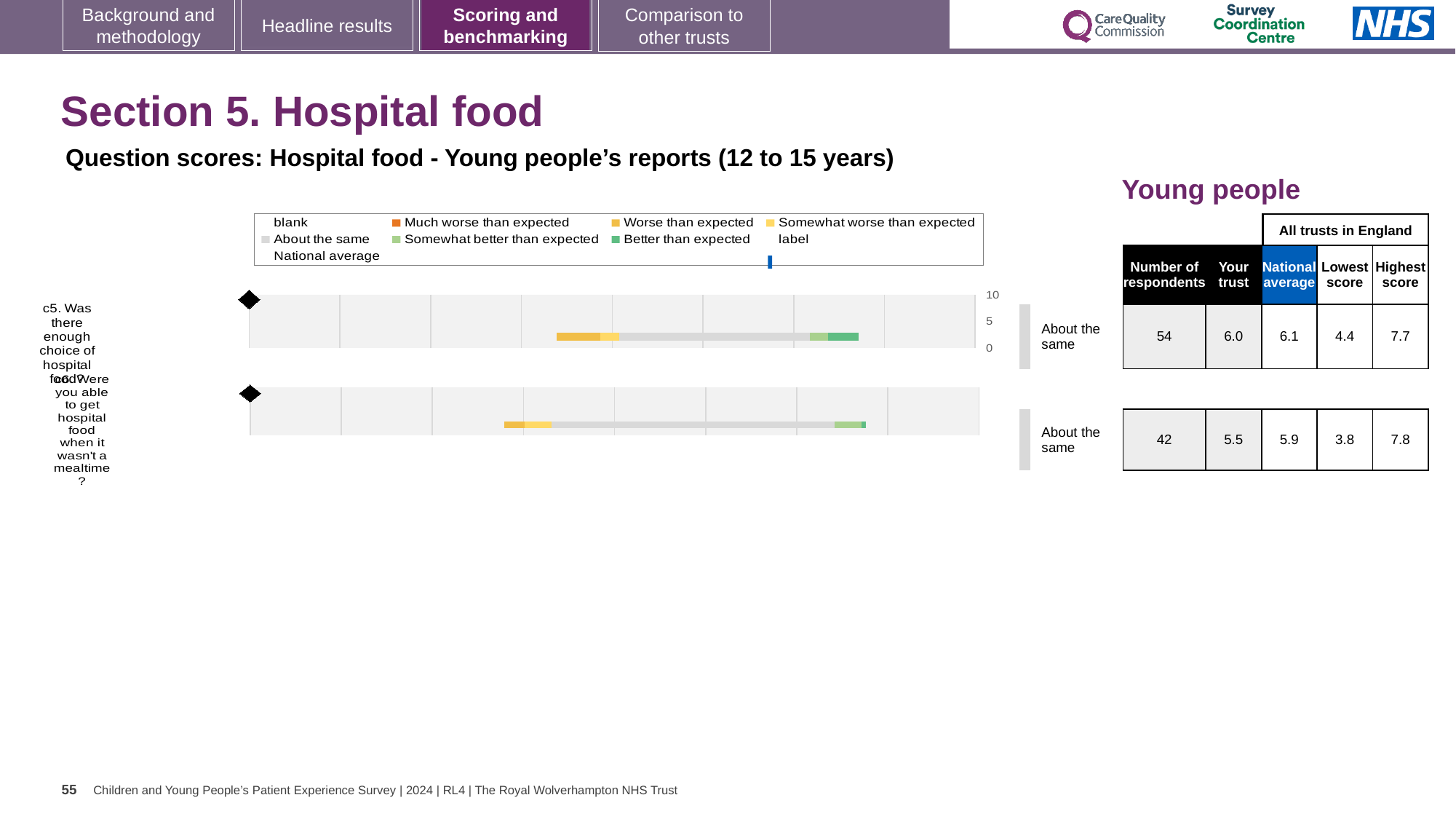
How many questions (rows) are plotted in the hospital food chart? 2 What kind of chart is used to show the question scores for hospital food? bar chart What is the difference between the highest and lowest scores across all trusts for question c6? 4.0 What is the national average score for question c6? 5.9 What benchmark category is given for both c5 and c6 in the chart? About the same What is the maximum value shown on the score axis of the chart? 10 What is the 'Your trust' score for question c5 (Was there enough choice of hospital food?)? 6.0 What is the 'Your trust' score for question c6 (Were you able to get hospital food when it wasn't a mealtime?)? 5.5 What is the highest score across all trusts in England for question c5? 7.7 What is the national average score for question c5? 6.1 Which question has the higher 'Your trust' score, c5 or c6? c5 How many respondents answered question c6? 42